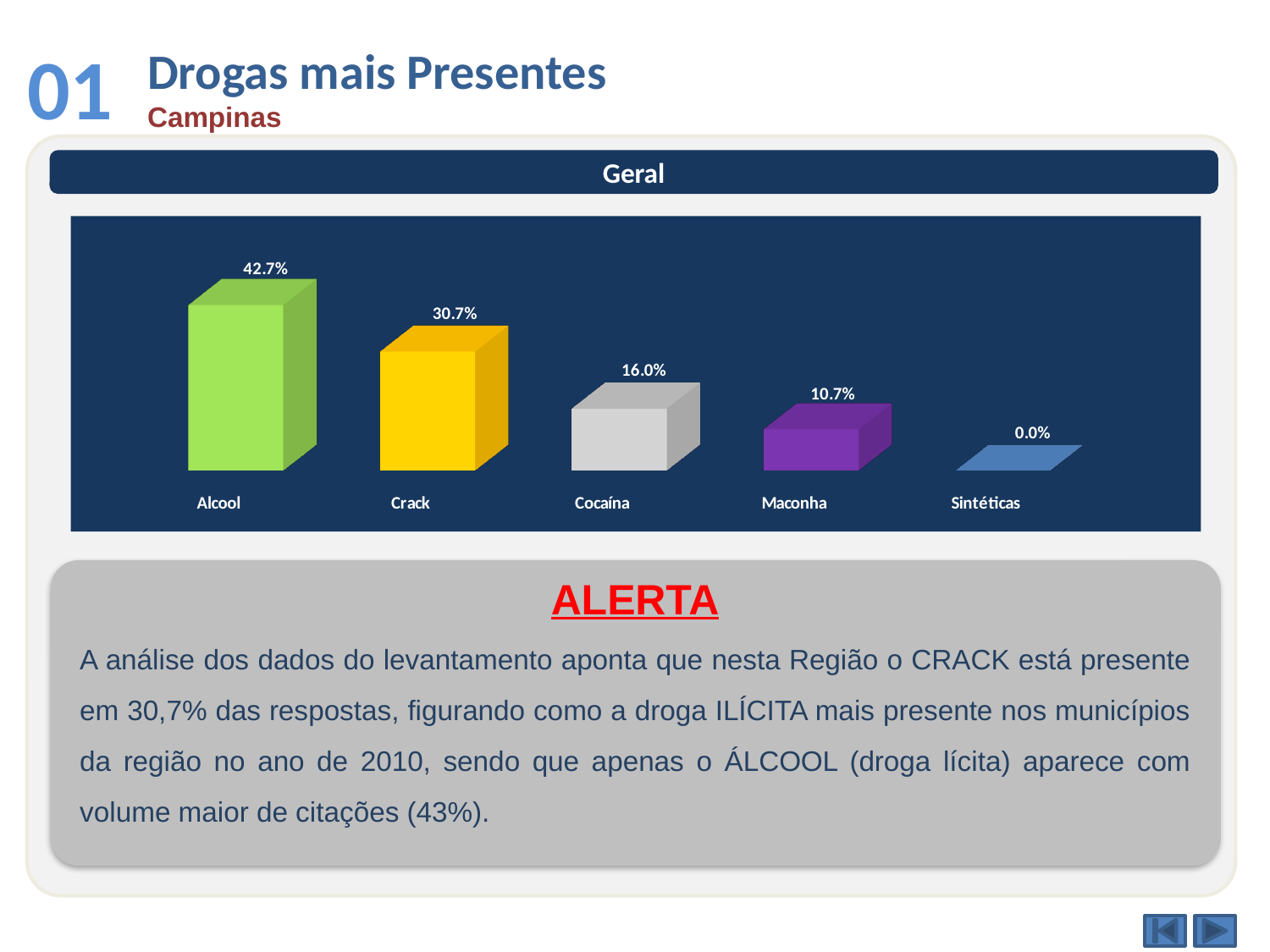
What is the value for Sintéticas? 0.0% What is the value for Crack? 30.7% Which is larger, the value for Cocaína or the value for Maconha? Cocaína Which category has the lowest value? Sintéticas What is the value for Cocaína? 16.0% What is the value for Alcool? 42.7% What kind of chart is shown on the slide? Bar chart Which category has the highest value? Alcool What is the difference between the values for Alcool and Crack? 12.0% What is the value for Maconha? 10.7% How many categories are shown in the chart? 5 Do the values rise or fall from left to right along the x axis? Fall